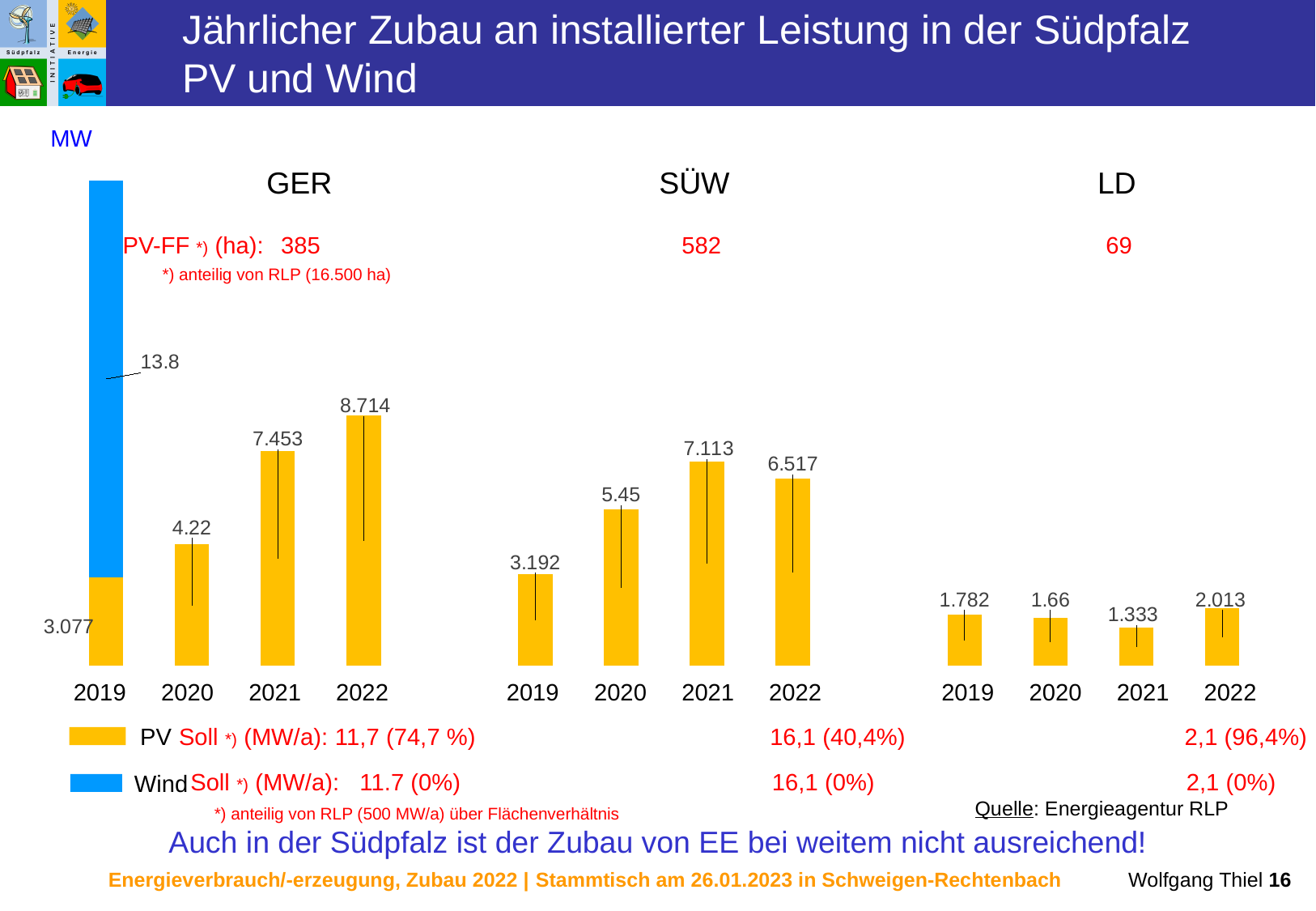
What is the total of the stacked bar for GER in 2019 (PV plus Wind)? 16.877 What is the Wind value shown for GER in 2019? 13.8 In the SÜW group, which year has the highest PV value? 2021 What kind of chart is shown on the slide? bar chart How many series does the legend list? 2 In the GER group, do the PV values rise or fall from 2019 to 2022? rise In the SÜW group, is the PV value for 2021 or 2022 larger? 2021 In the GER group, what is the difference between the PV values for 2022 and 2021? 1.261 In the SÜW group, what is the PV value for 2020? 5.45 In the GER group, what is the PV value for 2022? 8.714 In the LD group, which year has the lowest PV value? 2021 In the LD group, what is the PV value for 2021? 1.333